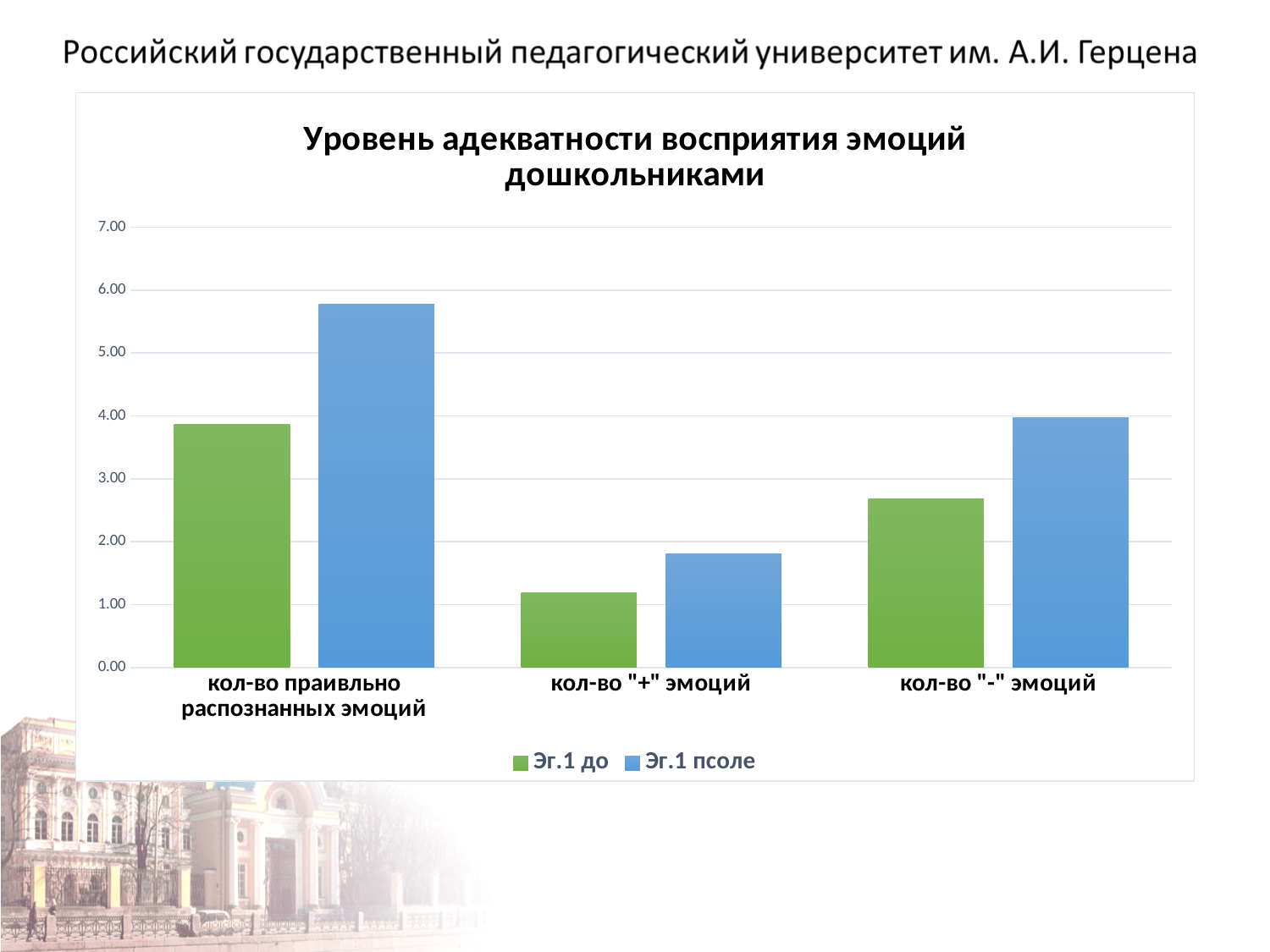
For "кол-во праивльно распознанных эмоций", which series has the larger value, Эг.1 до or Эг.1 псоле? Эг.1 псоле Is the value of Эг.1 псоле for "кол-во праивльно распознанных эмоций" greater or less than 5.00? greater How many series does the legend list? 2 Is the value of Эг.1 псоле for "кол-во "+" эмоций" greater or less than 2.00? less What kind of chart is shown on the slide? bar chart Which category has the highest bar for the series Эг.1 псоле? кол-во праивльно распознанных эмоций What are the two series named in the legend? Эг.1 до and Эг.1 псоле Is the value of Эг.1 до for "кол-во "-" эмоций" greater or less than 3.00? less How many categories are shown on the x axis? 3 For "кол-во "-" эмоций", which series has the larger value, Эг.1 до or Эг.1 псоле? Эг.1 псоле What is the title of the chart? Уровень адекватности восприятия эмоций дошкольниками Which category has the lowest bar for the series Эг.1 до? кол-во "+" эмоций